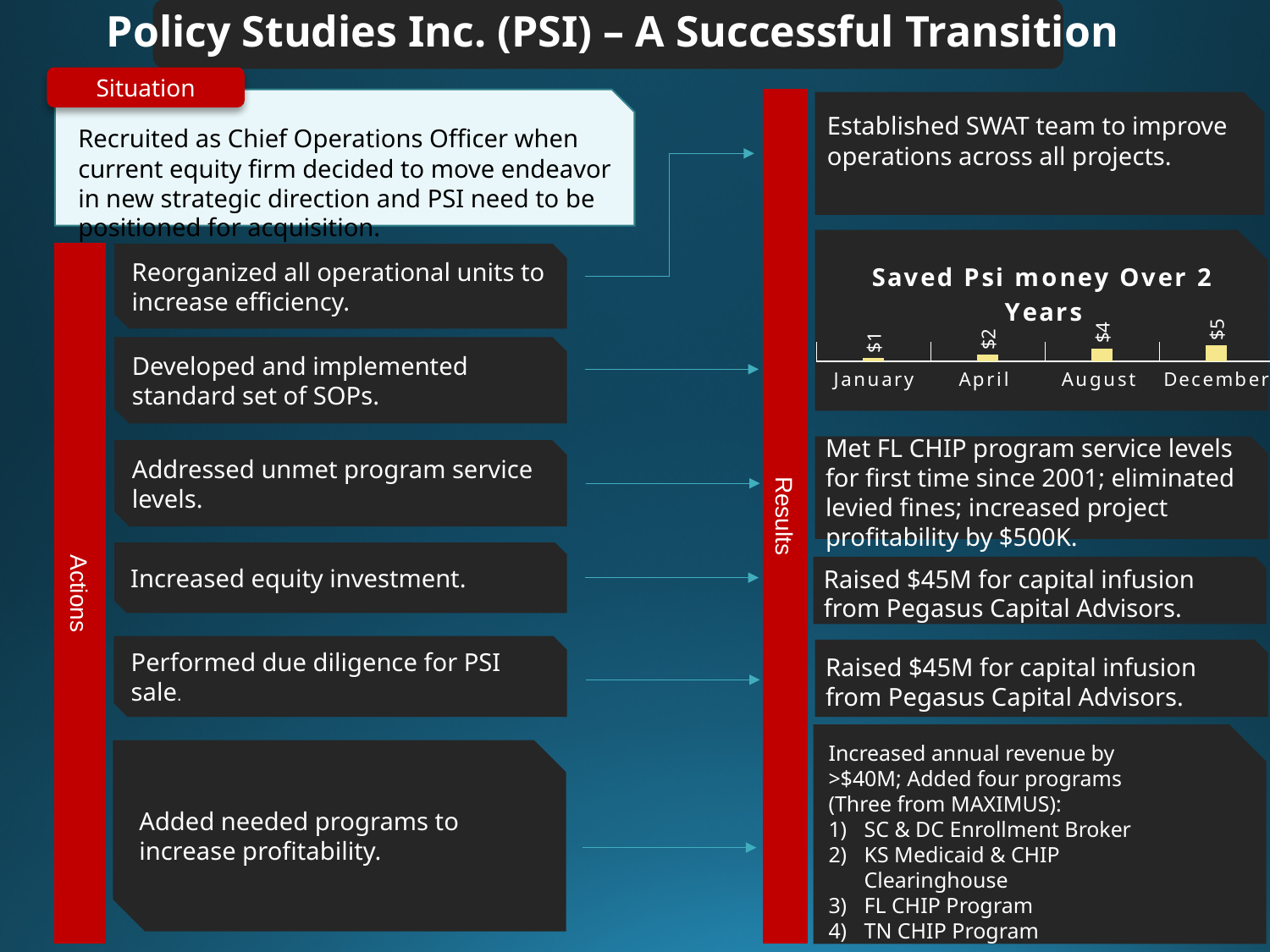
What is the title of the chart on the slide? Saved Psi money Over 2 Years Which month has the lowest value in the "Saved Psi money Over 2 Years" chart? January In the "Saved Psi money Over 2 Years" chart, what is the difference between the December and January values? $4 In the "Saved Psi money Over 2 Years" chart, what is the value for August? $4 In the "Saved Psi money Over 2 Years" chart, what is the value for April? $2 What kind of chart is shown under the title "Saved Psi money Over 2 Years"? bar chart In the "Saved Psi money Over 2 Years" chart, what is the value for December? $5 Do the values in the "Saved Psi money Over 2 Years" chart rise or fall from January to December? rise In the "Saved Psi money Over 2 Years" chart, which is larger, the value for April or the value for August? August Which month has the highest value in the "Saved Psi money Over 2 Years" chart? December In the "Saved Psi money Over 2 Years" chart, what is the value for January? $1 How many months are shown on the x axis of the "Saved Psi money Over 2 Years" chart? 4